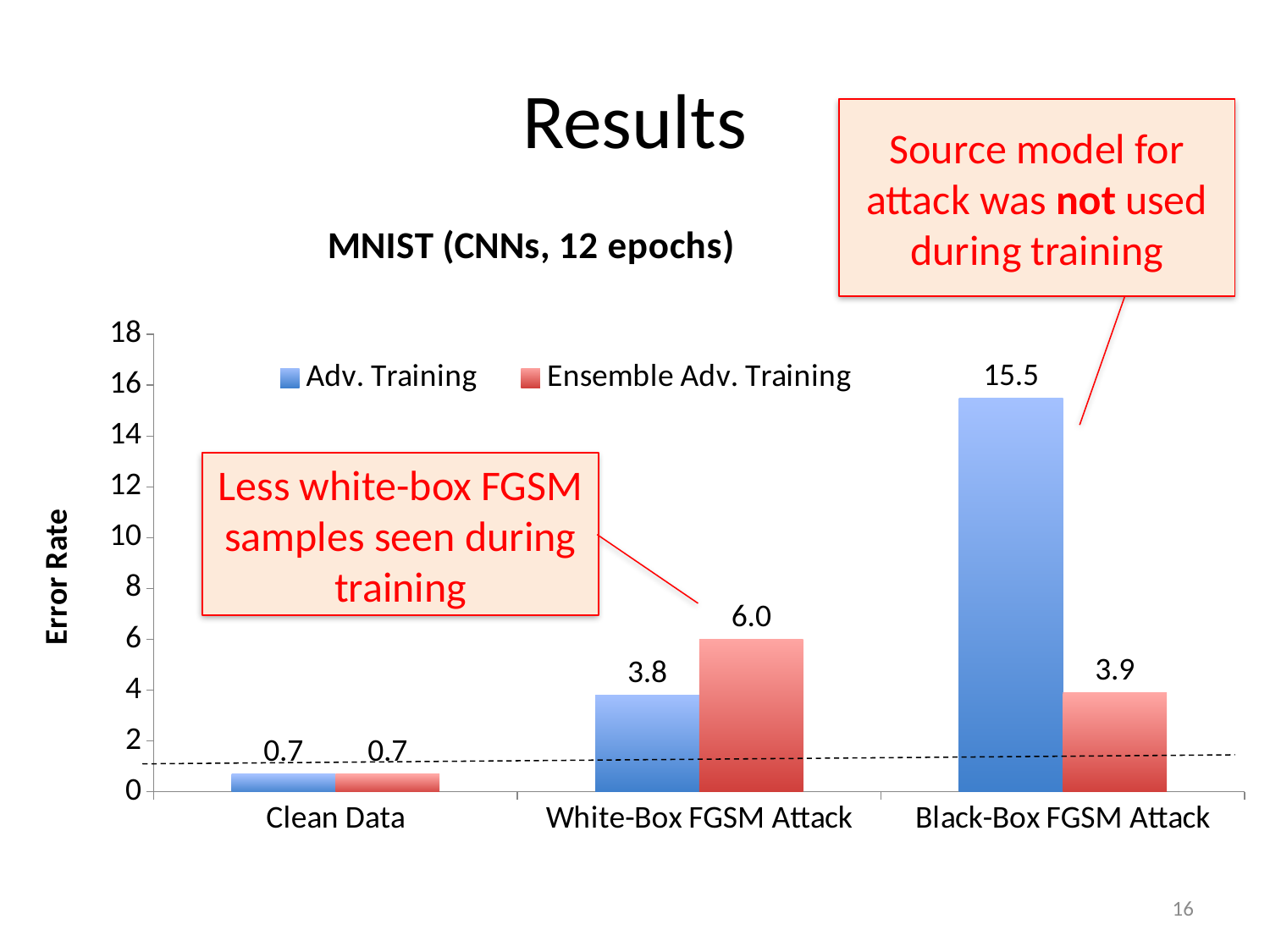
How many series does the legend list? 2 What kind of chart is shown on the slide? Bar chart What is the title of the chart? MNIST (CNNs, 12 epochs) How many categories are shown on the x axis? 3 Under the White-Box FGSM Attack, which has the larger error rate, Adv. Training or Ensemble Adv. Training? Ensemble Adv. Training What is the error rate for Adv. Training under the Black-Box FGSM Attack? 15.5 What is the error rate for Ensemble Adv. Training under the Black-Box FGSM Attack? 3.9 Which category has the highest error rate for Ensemble Adv. Training? White-Box FGSM Attack What is the difference between the Adv. Training and Ensemble Adv. Training error rates under the Black-Box FGSM Attack? 11.6 What is the error rate for Adv. Training on Clean Data? 0.7 Which category has the highest error rate for Adv. Training? Black-Box FGSM Attack What is the error rate for Ensemble Adv. Training under the White-Box FGSM Attack? 6.0